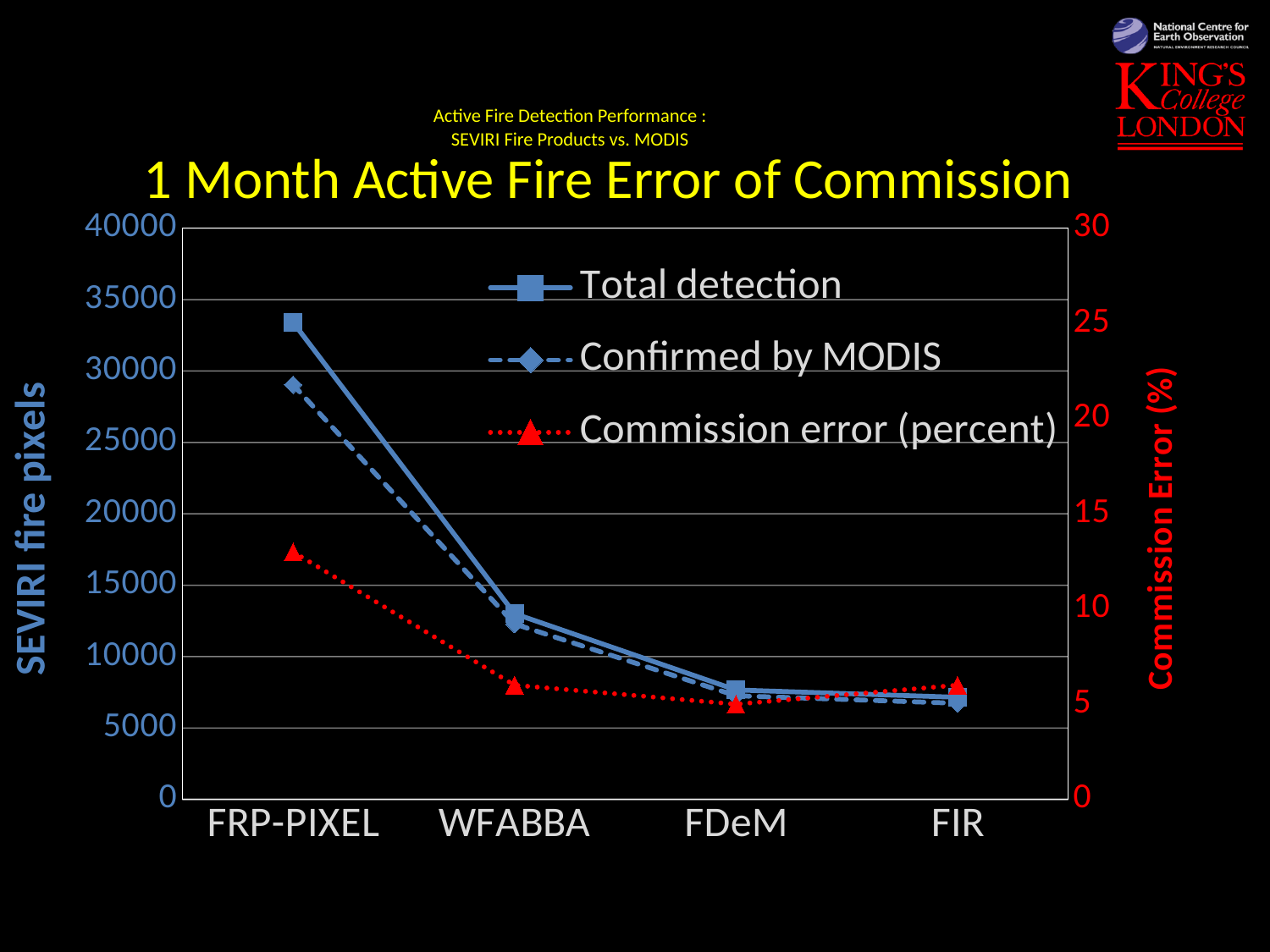
Does the Total detection series rise or fall from FRP-PIXEL to FIR? fall Is the Commission error (percent) for FRP-PIXEL greater or less than 10? greater Is the Commission error (percent) for WFABBA greater or less than 10? less Which category has the highest Total detection value? FRP-PIXEL Which category has the highest Commission error (percent)? FRP-PIXEL Is the Total detection value for FRP-PIXEL greater or less than 30000? greater What is the label of the right-hand vertical axis? Commission Error (%) Which is larger, the Total detection value for FRP-PIXEL or for WFABBA? FRP-PIXEL What kind of chart is shown on the slide? line chart How many categories are shown on the x axis? 4 How many series does the legend list? 3